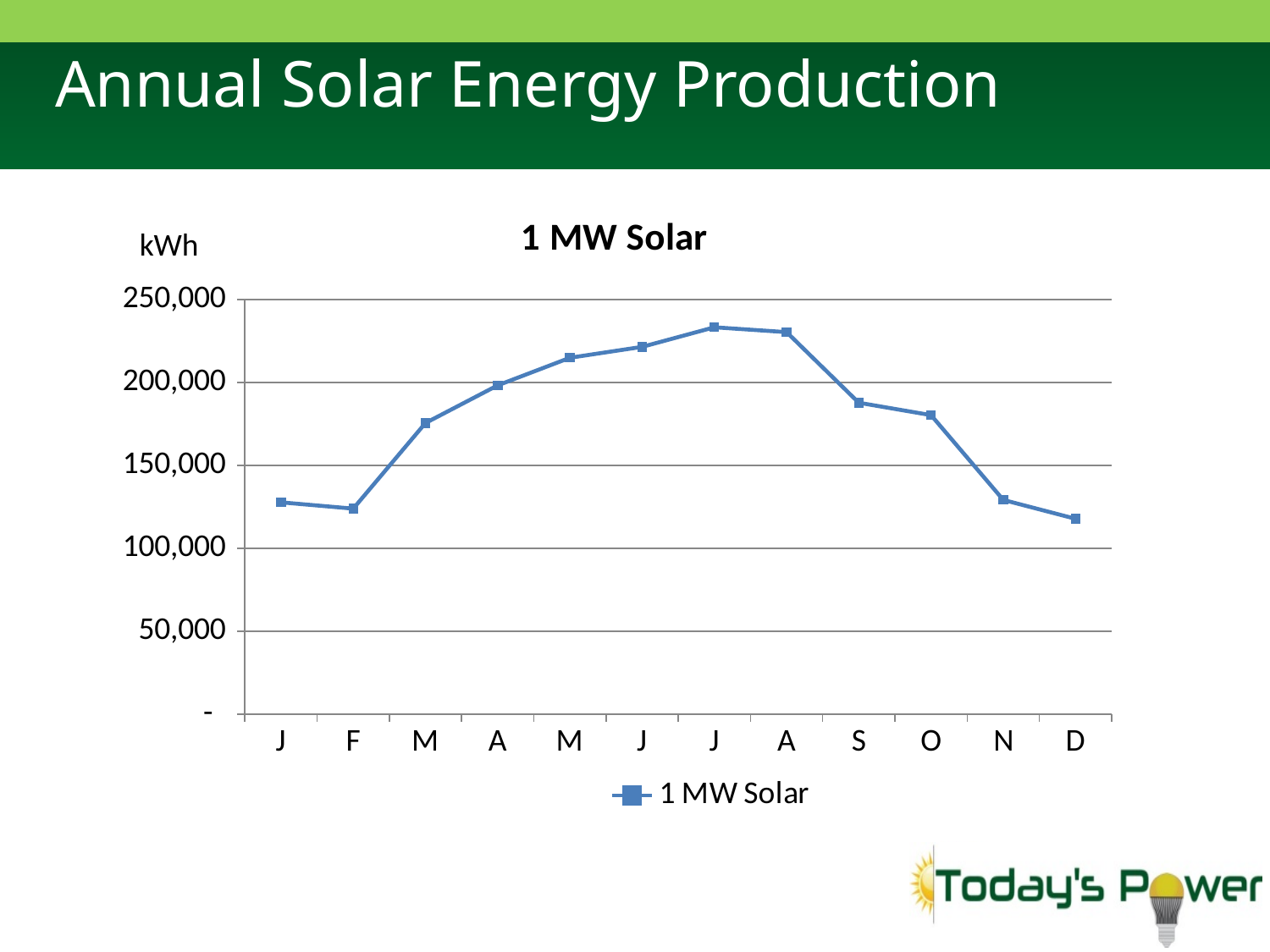
How many data points are plotted along the x axis of the 1 MW Solar chart? 12 Which has the larger value, the third month (M, third point from the left) or the eleventh month (N)? M (third month) Is the value for the seventh month (J, seventh point from the left) greater or less than 200,000? greater Is the value for the ninth month (S) greater or less than 200,000? less What is the title of the chart on the slide? 1 MW Solar How many series does the legend of the 1 MW Solar chart list? 1 Is the value for the eleventh month (N) greater or less than 150,000? less What unit is shown above the vertical axis of the chart? kWh What kind of chart is shown on the slide? line chart Do the values rise or fall from the eighth month (A) to the twelfth month (D)? fall